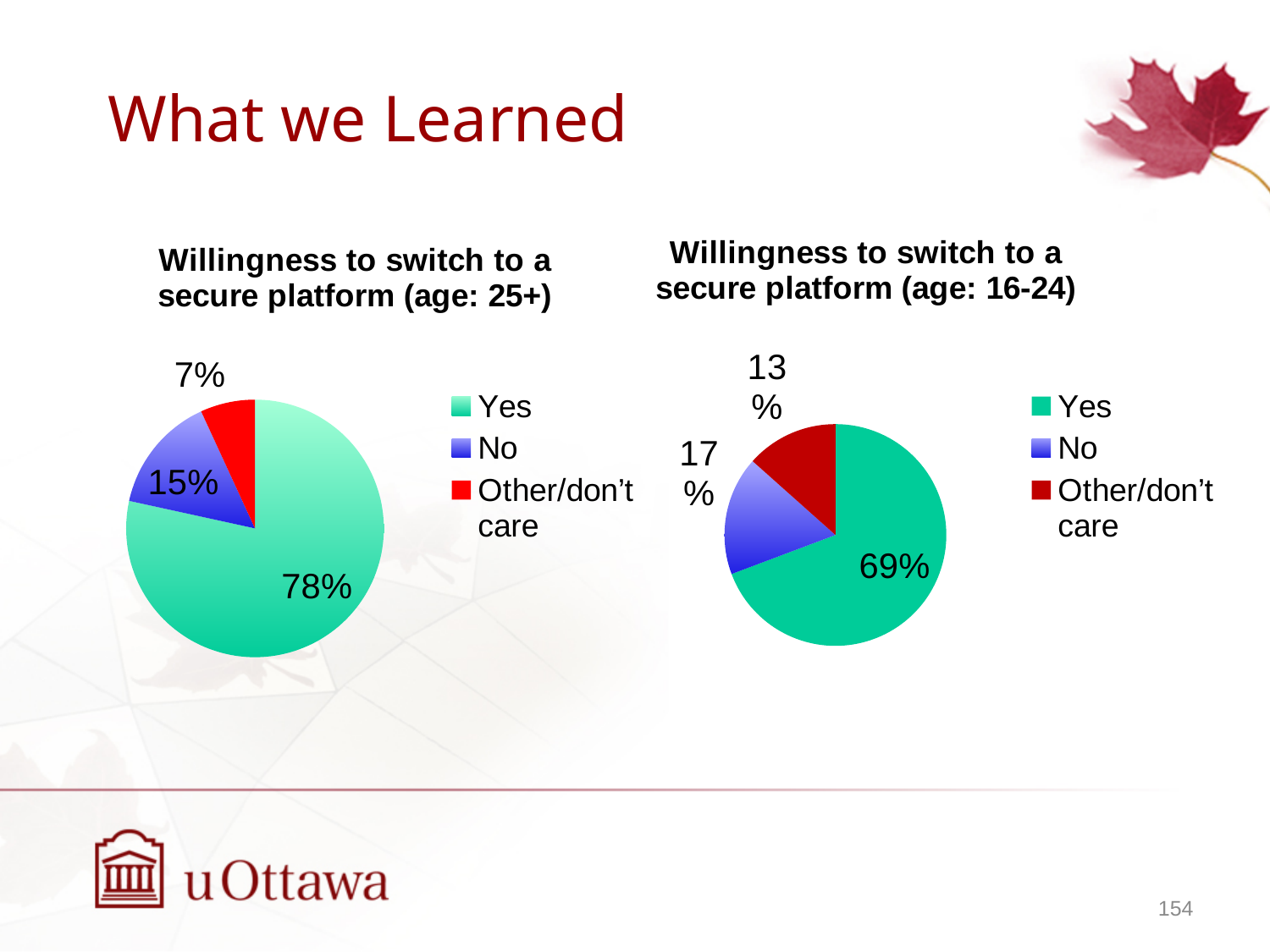
In the 'Willingness to switch to a secure platform (age: 25+)' chart, what percentage answered No? 15% In the 'Willingness to switch to a secure platform (age: 16-24)' chart, what percentage answered Yes? 69% In the 'Willingness to switch to a secure platform (age: 16-24)' chart, what percentage is Other/don't care? 13% What type of chart is used on this slide? Pie chart How many categories does the legend of the 'Willingness to switch to a secure platform (age: 16-24)' chart list? 3 In the 'Willingness to switch to a secure platform (age: 25+)' chart, what percentage answered Yes? 78% In the 'Willingness to switch to a secure platform (age: 25+)' chart, which category has the largest share? Yes Which chart has the larger No share, the age 25+ chart or the age 16-24 chart? The age 16-24 chart What is the difference between the Yes share in the age 25+ chart and the Yes share in the age 16-24 chart? 9 percentage points In the 'Willingness to switch to a secure platform (age: 16-24)' chart, which category has the smallest share? Other/don't care In the 'Willingness to switch to a secure platform (age: 16-24)' chart, what percentage answered No? 17% In the 'Willingness to switch to a secure platform (age: 25+)' chart, what percentage is Other/don't care? 7%